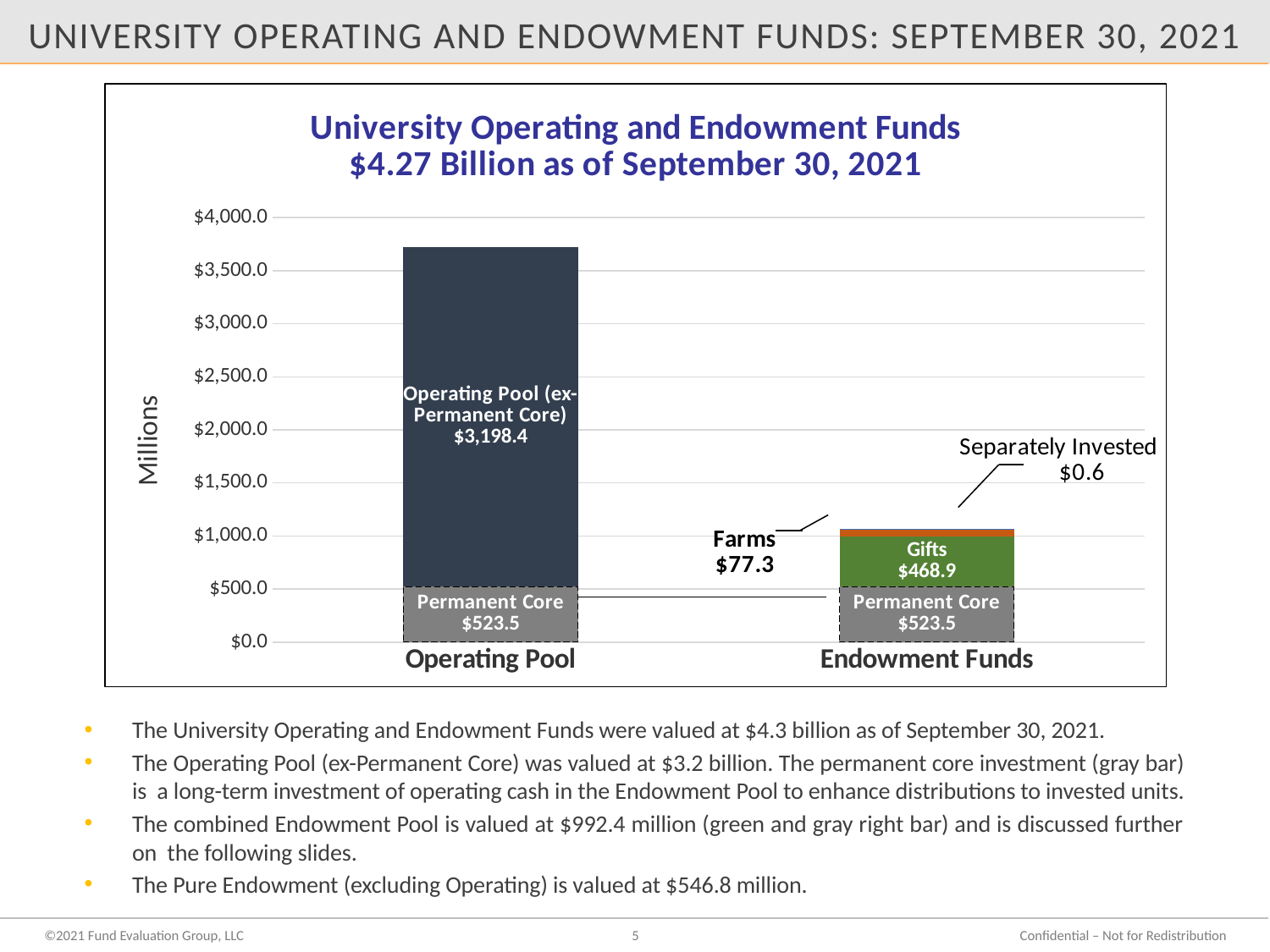
What is the value of the Farms segment in the Endowment Funds bar? $77.3 What is the value of the Separately Invested segment in the Endowment Funds bar? $0.6 What is the difference between the Operating Pool (ex-Permanent Core) segment and the Permanent Core segment in the Operating Pool bar? $2,674.9 What is the difference between the Gifts segment and the Farms segment in the Endowment Funds bar? $391.6 What is the total of the Endowment Funds stacked bar? $1,070.3 Which category has the taller stacked bar, Operating Pool or Endowment Funds? Operating Pool What is the value of the Operating Pool (ex-Permanent Core) segment in the Operating Pool bar? $3,198.4 What is the value of the Gifts segment in the Endowment Funds bar? $468.9 How many categories are shown on the x axis of the chart? 2 What is the value of the Permanent Core segment in the Operating Pool bar? $523.5 What is the total of the Operating Pool stacked bar? $3,721.9 What kind of chart is shown on the slide? Stacked bar chart